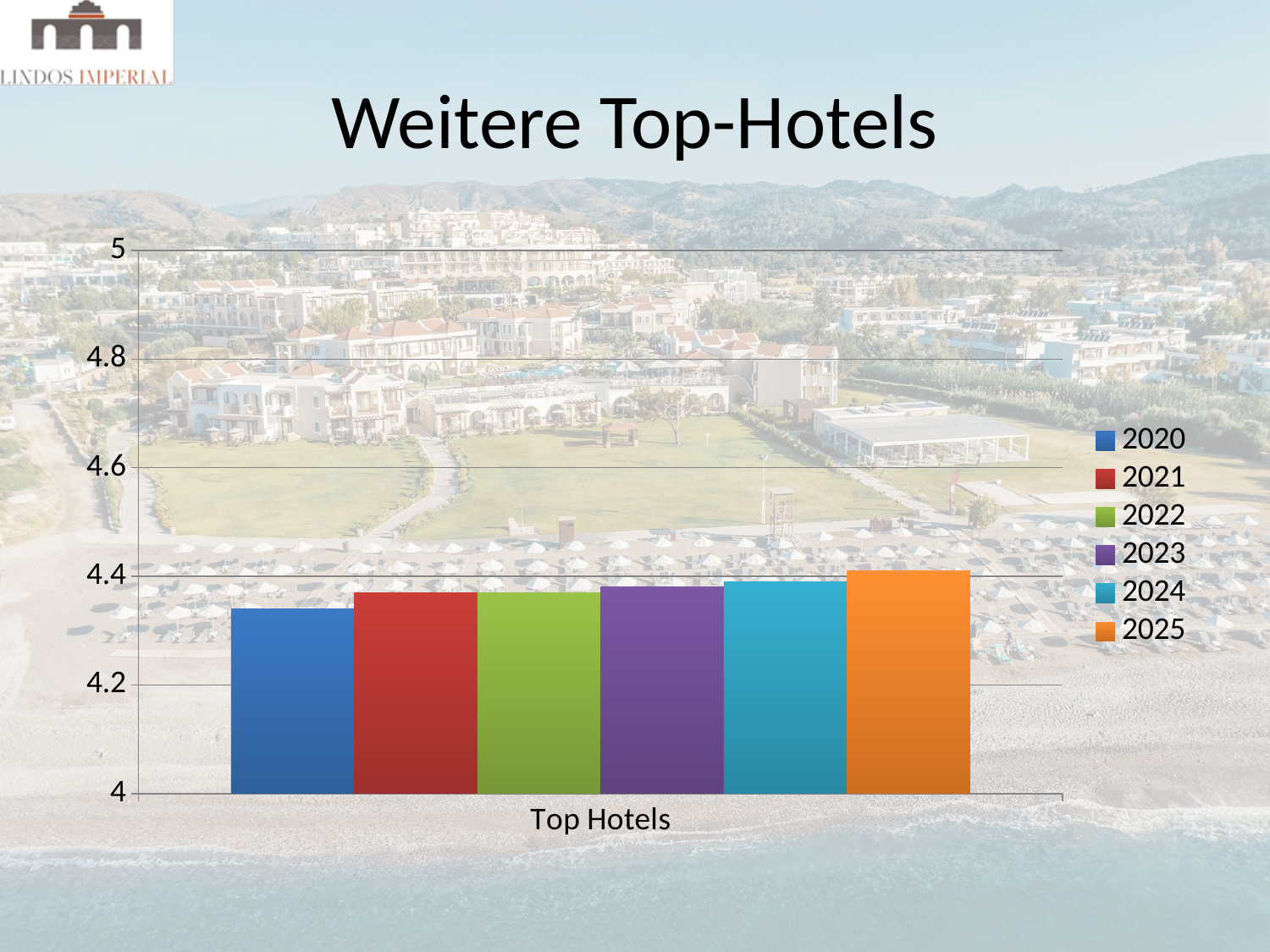
What kind of chart is shown on the slide? bar chart Do the values rise or fall from 2020 to 2025? rise How many series does the legend list? 6 Is the value for 2021 greater or less than 4.4? less Is the value for 2020 greater or less than 4.2? greater Which year has the highest value for Top Hotels? 2025 What is the category label shown on the x axis? Top Hotels Is the value for 2020 greater or less than 4.4? less Which is larger, the value for 2020 or the value for 2025? 2025 How many categories are shown on the x axis? 1 Which year has the lowest value for Top Hotels? 2020